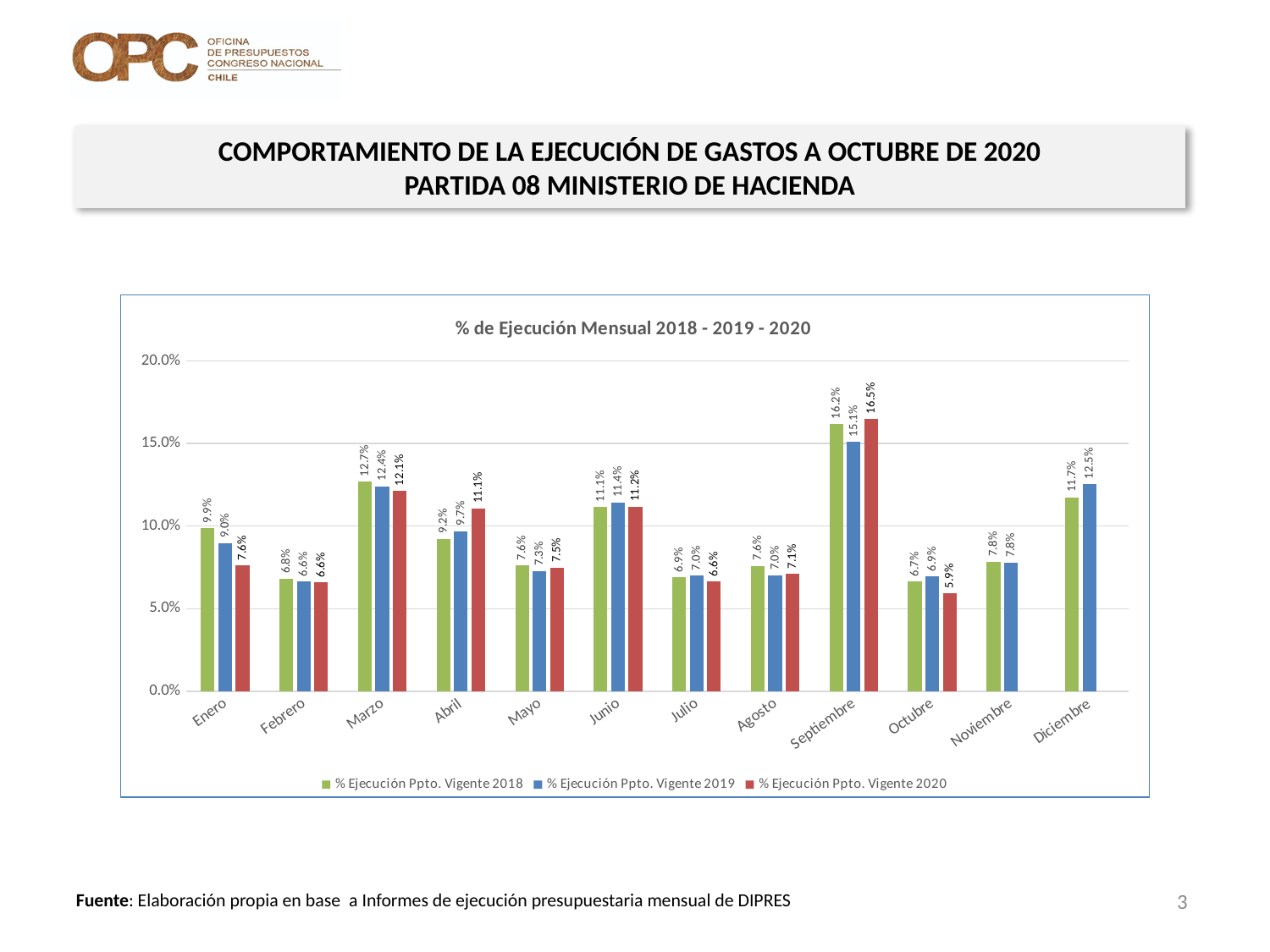
How many series does the legend list? 3 What is the % Ejecución Ppto. Vigente 2019 value for Diciembre? 12.5% What is the difference between the 2020 and 2018 values for Abril? 1.9% Is the % Ejecución Ppto. Vigente 2019 value for Septiembre greater or less than 15.0%? greater How many months are shown on the x axis? 12 Which month has the highest % Ejecución Ppto. Vigente 2020 value? Septiembre Which month has the lowest % Ejecución Ppto. Vigente 2020 value? Octubre What is the % Ejecución Ppto. Vigente 2020 value for Septiembre? 16.5% What is the % Ejecución Ppto. Vigente 2018 value for Marzo? 12.7% What is the title of the chart? % de Ejecución Mensual 2018 - 2019 - 2020 Which is larger for Enero: the 2018 value or the 2020 value? 2018 value (9.9%) What kind of chart is shown on the slide? Bar chart